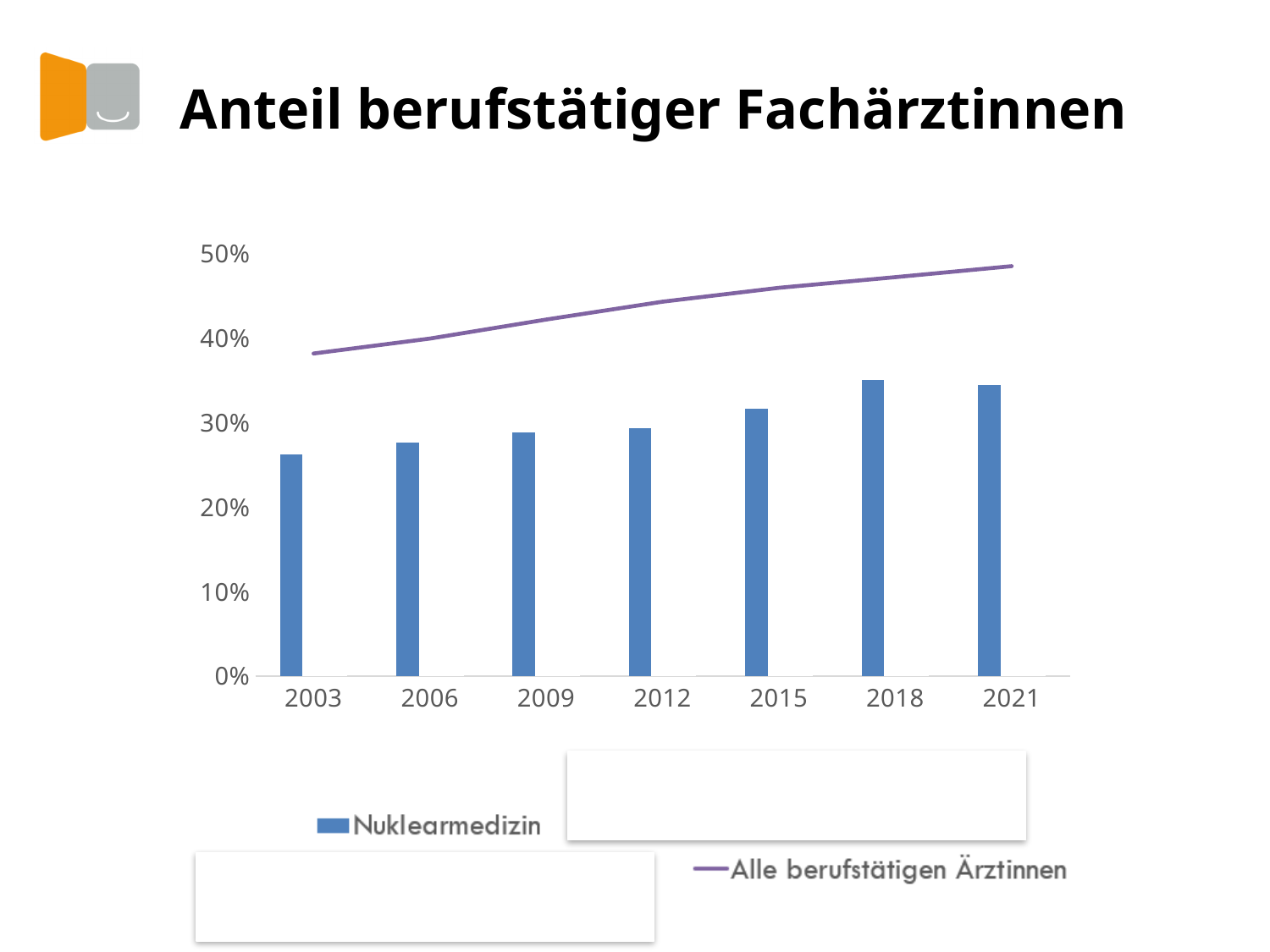
Is the Nuklearmedizin value for 2018 greater or less than 30%? greater Which series is drawn as bars in the chart? Nuklearmedizin What kind of chart is shown on the slide? A bar chart with a line series How many years are shown on the x axis of the chart? 7 Is the Nuklearmedizin value for 2003 greater or less than 30%? less In which year is the Nuklearmedizin bar the highest? 2018 What is the title of the slide's chart? Anteil berufstätiger Fachärztinnen In which year is the Nuklearmedizin bar the lowest? 2003 Does the Alle berufstätigen Ärztinnen line rise or fall from 2003 to 2021? rise Is the value of the Alle berufstätigen Ärztinnen line for 2021 greater or less than 40%? greater How many series does the chart's legend list? 2 Which is larger in 2021: the Nuklearmedizin bar or the Alle berufstätigen Ärztinnen line? Alle berufstätigen Ärztinnen